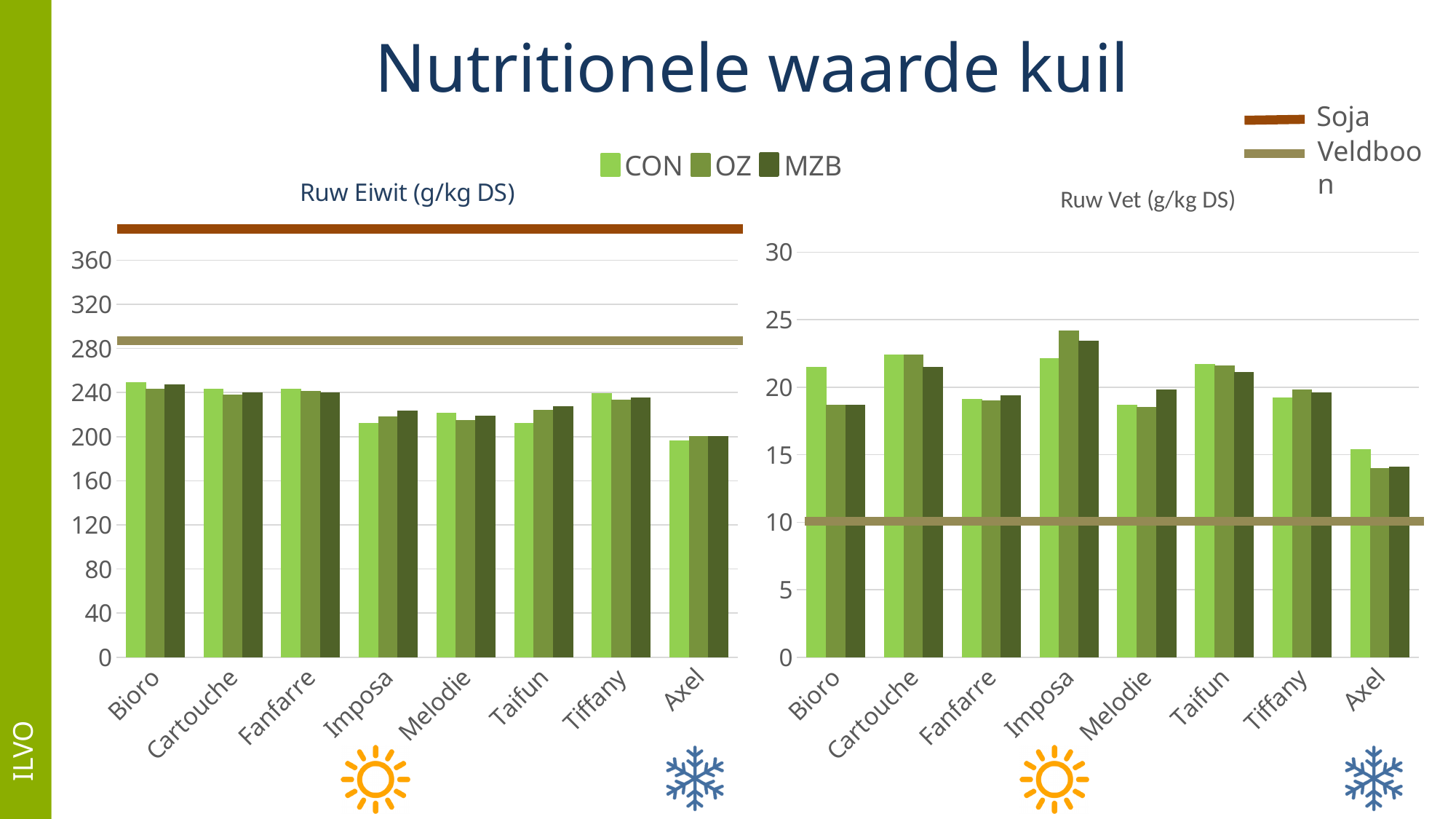
In the Ruw Eiwit (g/kg DS) chart, is the CON value for Bioro greater or less than 240? greater What are the names of the two reference lines shown in the legend at the top right of the slide? Soja and Veldboon In the Ruw Eiwit (g/kg DS) chart, is the CON value for Axel greater or less than 200? less In the Ruw Eiwit (g/kg DS) chart, which is larger: the CON value for Bioro or the CON value for Axel? Bioro What kind of chart is the Ruw Eiwit (g/kg DS) chart? bar chart In the Ruw Vet (g/kg DS) chart, is the OZ value for Imposa greater or less than 20? greater How many series does the legend list for the bar charts? 3 In the Ruw Vet (g/kg DS) chart, which category has the lowest values across all three series? Axel In the Ruw Vet (g/kg DS) chart, which category has the highest OZ value? Imposa How many categories are shown on the x axis of the Ruw Vet (g/kg DS) chart? 8